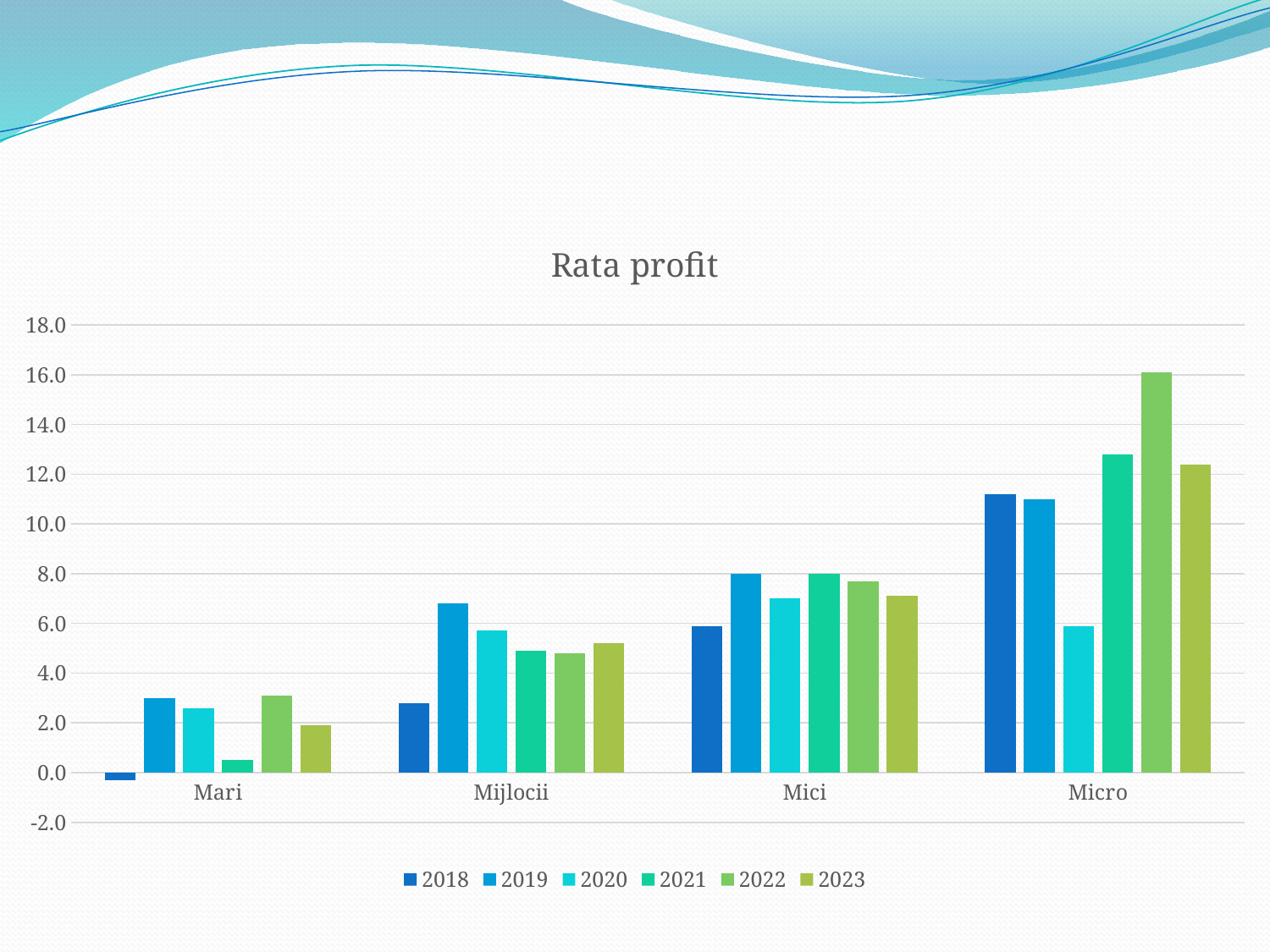
Is the value for Mijlocii in 2019 greater or less than 6.0? greater What kind of chart is shown on the slide? bar chart Which category has the highest value for 2022? Micro Which is larger, the value for Mici in 2018 or the value for Mijlocii in 2018? Mici in 2018 How many series does the legend list? 6 Is the value for Micro in 2022 greater or less than 14.0? greater Which is larger, the value for Micro in 2020 or the value for Micro in 2021? Micro in 2021 What is the title of the chart? Rata profit How many categories are shown on the x axis of the chart? 4 Which year has the lowest value in the Micro category? 2020 Is the value for Mari in 2021 greater or less than 2.0? less Which category has the lowest value for 2018? Mari